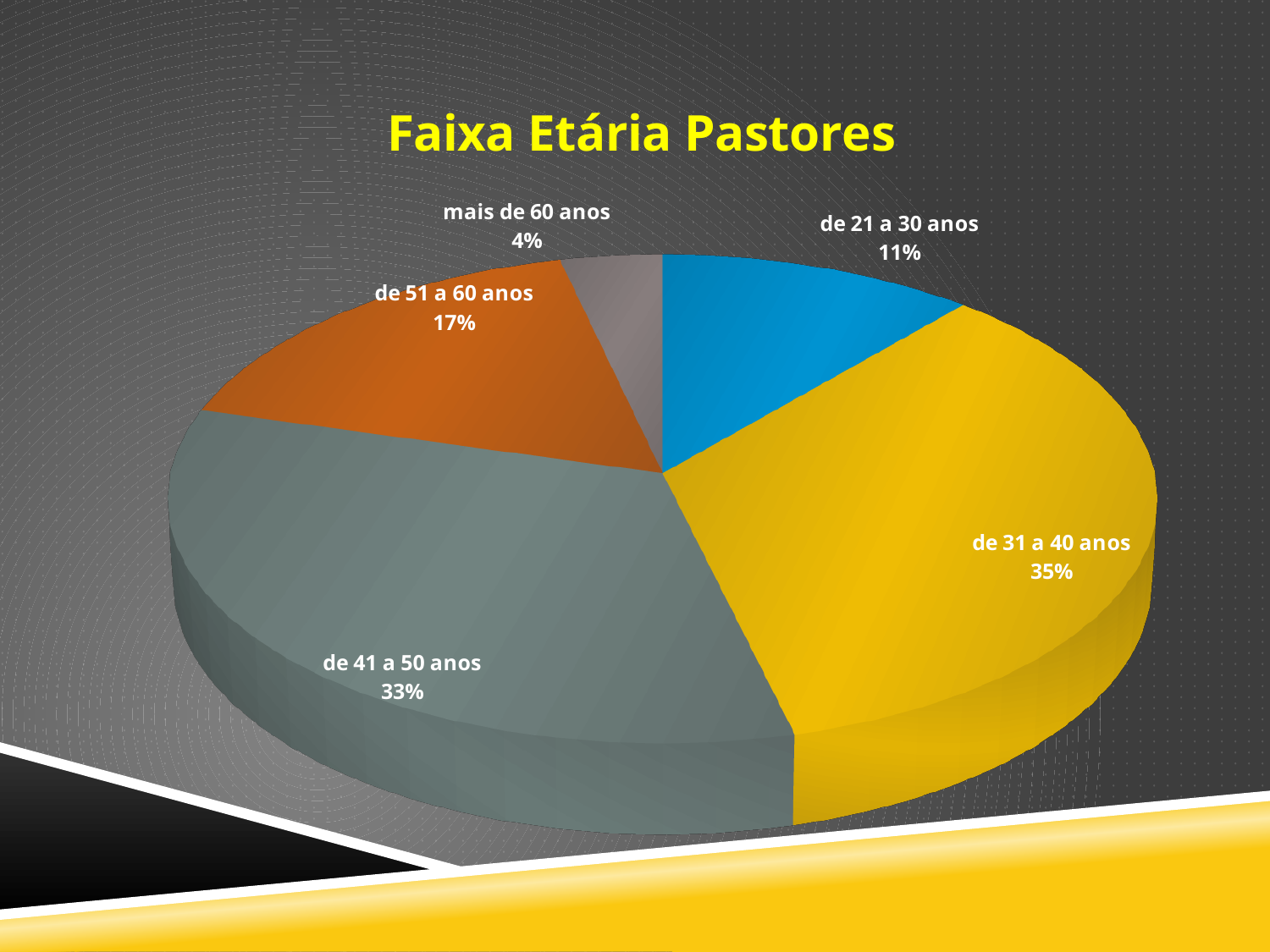
What percentage of pastors are in the 'de 31 a 40 anos' age group? 35% What is the title of the chart? Faixa Etária Pastores What percentage is shown for 'de 51 a 60 anos'? 17% What percentage is shown for 'de 21 a 30 anos'? 11% Which is larger: the share for 'de 21 a 30 anos' or for 'de 51 a 60 anos'? de 51 a 60 anos What is the difference in percentage points between 'de 41 a 50 anos' and 'de 51 a 60 anos'? 16 What colour is the slice for 'de 41 a 50 anos'? Grey What type of chart is shown on the slide? Pie chart How many age groups are shown in the pie chart? 5 Which age group has the smallest share of the pie? mais de 60 anos What share does the 'mais de 60 anos' slice represent? 4% Which age group has the largest share of the pie? de 31 a 40 anos